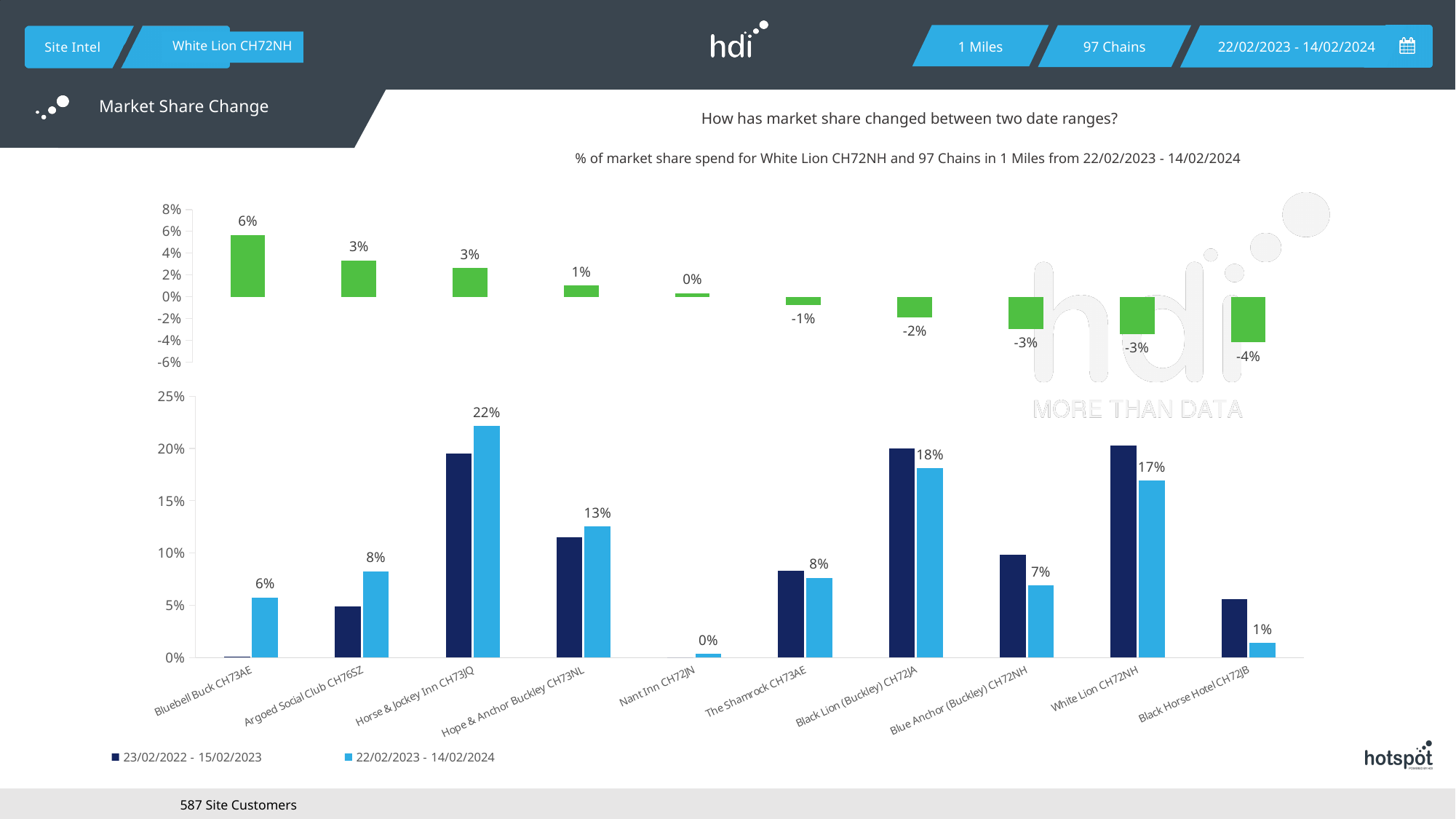
How many series does the legend of the bottom chart list? 2 In the top chart (market share change), what is the value for Black Horse Hotel CH72JB? -4% In the bottom chart, which is larger in the 22/02/2023 - 14/02/2024 series: Black Lion (Buckley) CH72JA or Hope & Anchor Buckley CH73NL? Black Lion (Buckley) CH72JA In the bottom chart, is the 23/02/2022 - 15/02/2023 value for The Shamrock CH73AE greater or less than 10%? less In the bottom chart, what is the difference between the 22/02/2023 - 14/02/2024 values for Horse & Jockey Inn CH73JQ and White Lion CH72NH? 5% In the top chart (market share change), which category has the lowest value? Black Horse Hotel CH72JB In the bottom chart, what is the value for White Lion CH72NH in the 22/02/2023 - 14/02/2024 series? 17% In the bottom chart, what is the value for Horse & Jockey Inn CH73JQ in the 22/02/2023 - 14/02/2024 series? 22% In the top chart (market share change), which category has the highest value? Bluebell Buck CH73AE In the top chart (market share change), what is the value for Bluebell Buck CH73AE? 6% In the bottom chart, is the 23/02/2022 - 15/02/2023 value for Hope & Anchor Buckley CH73NL greater or less than 10%? greater How many categories are shown on the x axis of the bottom chart? 10